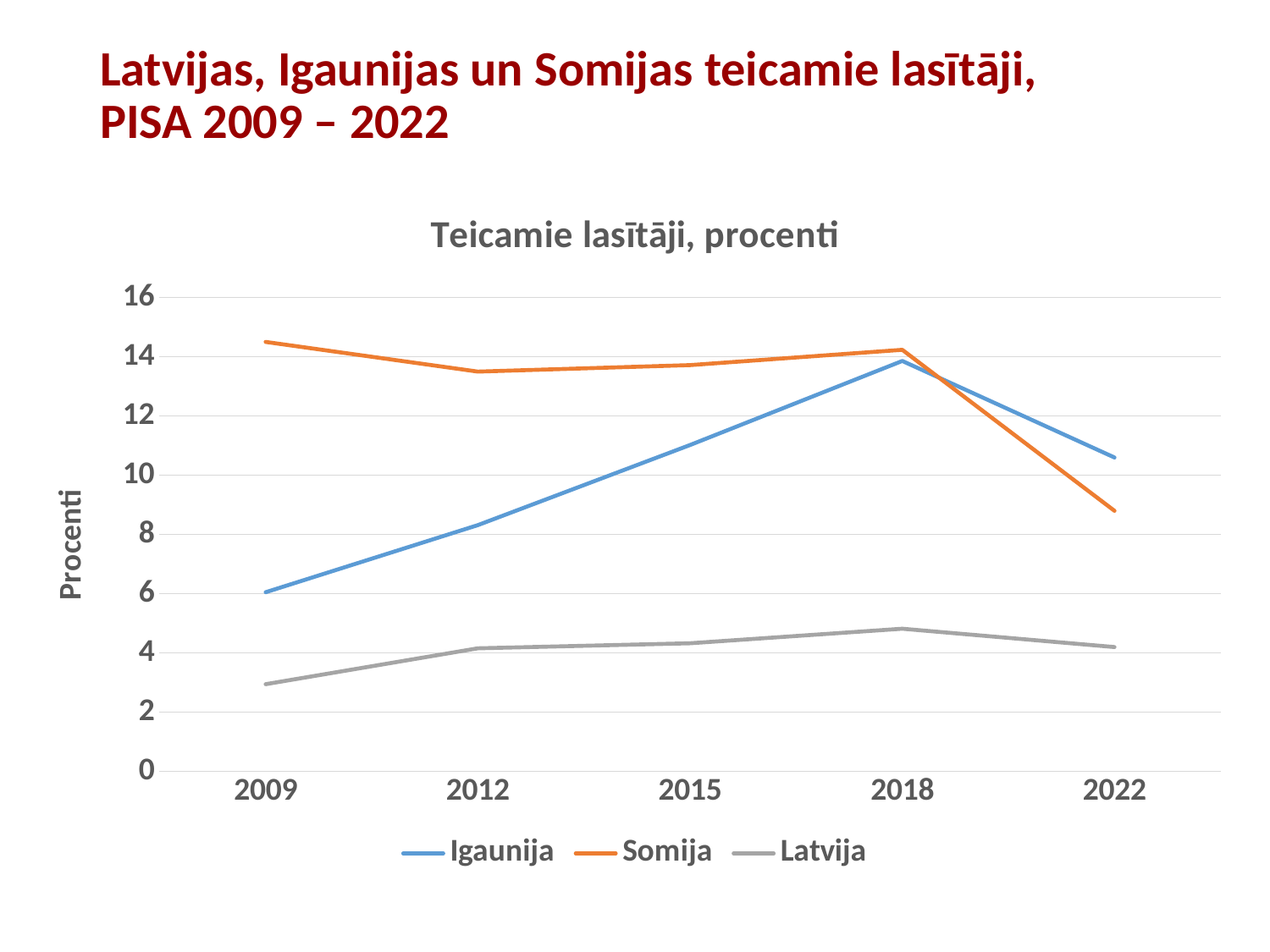
Does the value for Igaunija rise or fall from 2009 to 2018? rise Which is larger in 2012, the value for Somija or the value for Igaunija? Somija Which series has the lowest value in 2022? Latvija How many series does the legend list? 3 Which series is shown in orange? Somija What is the title of the chart? Teicamie lasītāji, procenti Is the value for Latvija in 2009 greater or less than 4? less Which series has the highest value in 2009? Somija How many years are plotted along the x axis? 5 Is the value for Igaunija in 2018 greater or less than 12? greater Which is larger in 2022, the value for Igaunija or the value for Somija? Igaunija What kind of chart is shown on the slide? line chart